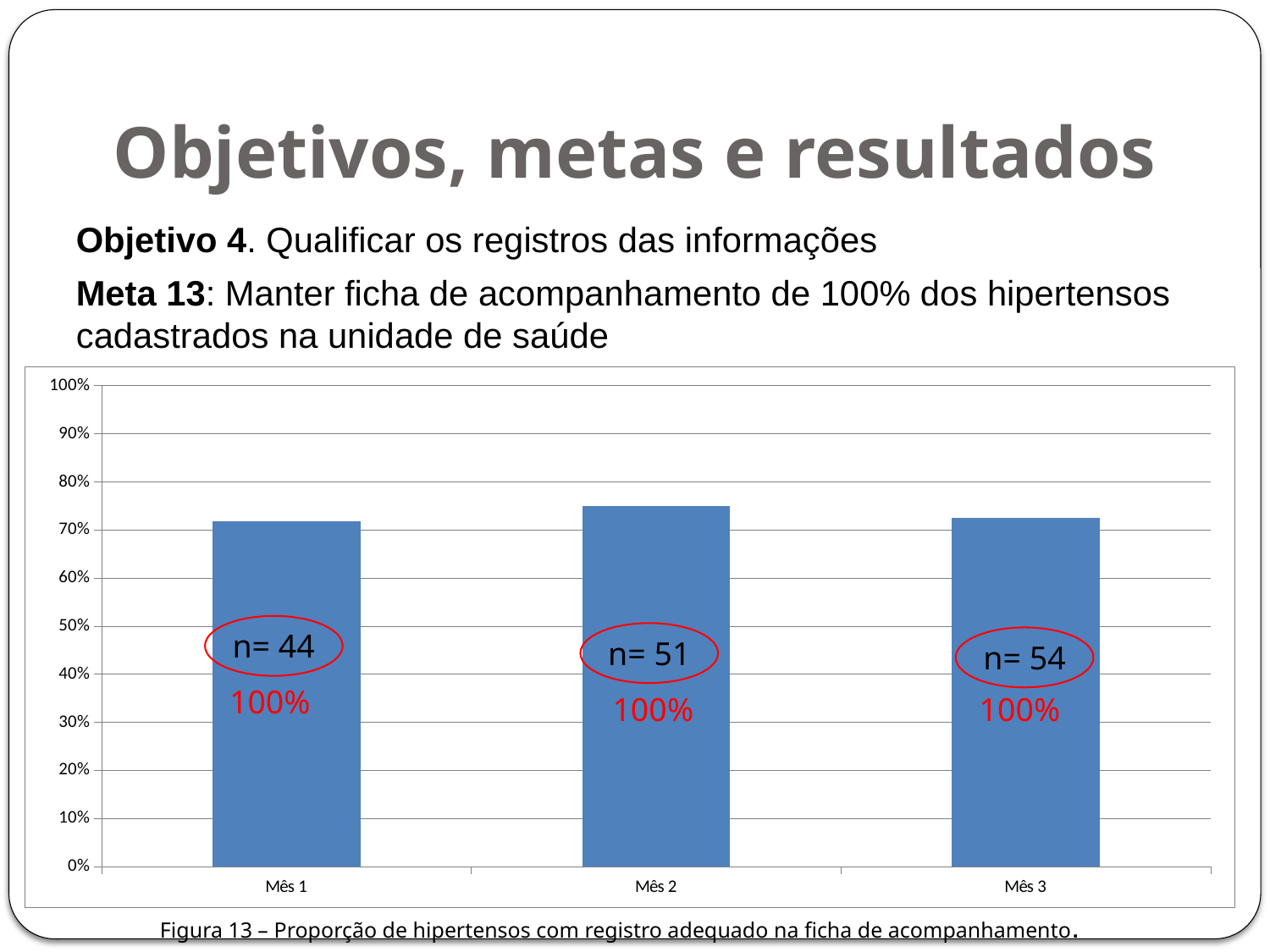
Which month has the highest n value printed on its bar? Mês 3 How many months (categories) are shown on the x axis of the chart? 3 What is the highest value shown on the chart's y axis? 100% What is the n value printed on the bar for Mês 1? n= 44 What is the difference between the n values printed for Mês 3 and Mês 1? 10 What is the n value printed on the bar for Mês 2? n= 51 What percentage label is printed on the bar for Mês 2? 100% What kind of chart is shown on the slide? bar chart Which has a larger printed n value, Mês 1 or Mês 2? Mês 2 What is the n value printed on the bar for Mês 3? n= 54 What is the caption (figure title) given below the chart? Figura 13 – Proporção de hipertensos com registro adequado na ficha de acompanhamento. Which month has the lowest n value printed on its bar? Mês 1